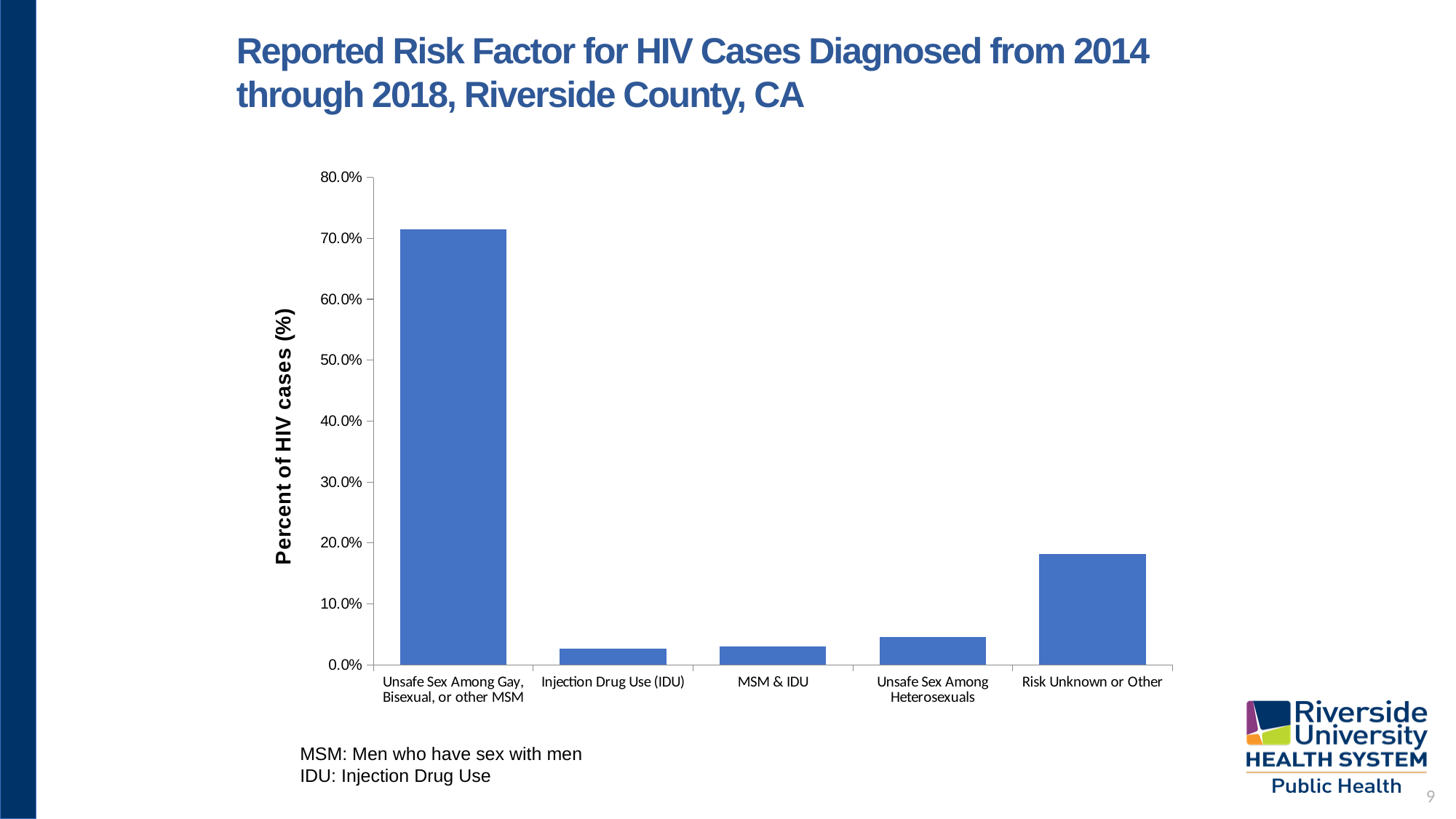
Is the value for Unsafe Sex Among Heterosexuals greater or less than 10.0%? less Which is larger: the value for Risk Unknown or Other or the value for Unsafe Sex Among Heterosexuals? Risk Unknown or Other Is the value for Unsafe Sex Among Gay, Bisexual, or other MSM greater or less than 60.0%? greater What type of chart is shown on the slide? bar chart What is the label of the y axis? Percent of HIV cases (%) How many risk factor categories are shown on the x axis? 5 Is the value for Risk Unknown or Other greater or less than 10.0%? greater What is the highest value shown on the y axis? 80.0% Which is larger: the value for Unsafe Sex Among Heterosexuals or the value for Injection Drug Use (IDU)? Unsafe Sex Among Heterosexuals Which risk factor category has the highest percent of HIV cases? Unsafe Sex Among Gay, Bisexual, or other MSM